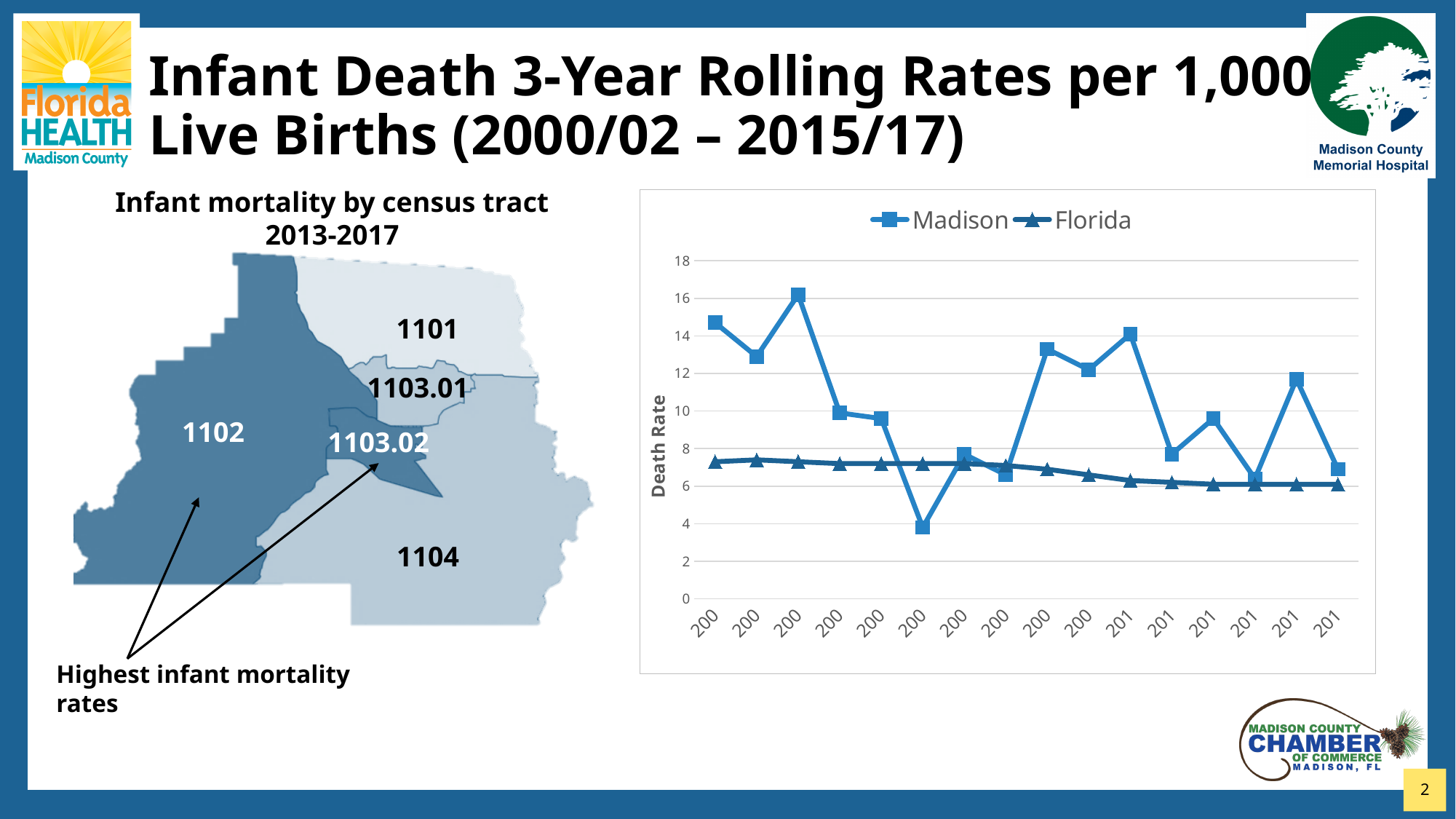
Is the highest Madison value on the line chart greater or less than 14? greater What are the two series named in the legend of the line chart? Madison and Florida What kind of chart is shown on the right side of the slide? line chart Is the lowest Madison value on the line chart greater or less than 6? less At the third point from the left on the line chart, which series has the higher value, Madison or Florida? Madison Which series reaches the highest value anywhere on the line chart? Madison What is the label on the vertical axis of the line chart? Death Rate Is the first (leftmost) Madison value on the line chart greater or less than 12? greater How many data points does each series in the line chart have? 16 How many series does the legend of the line chart list? 2 Does the Florida line generally rise or fall from left to right across the chart? fall